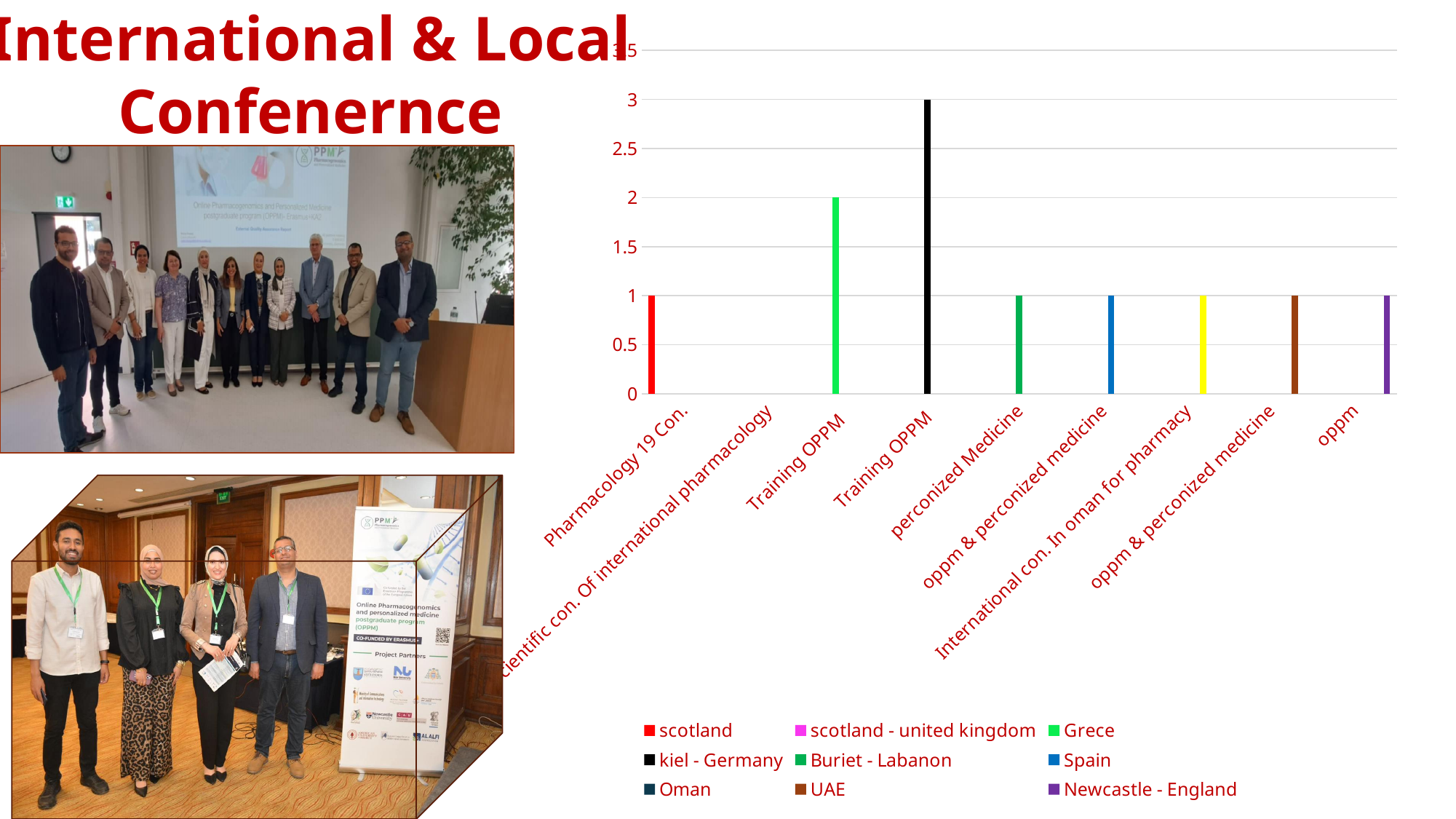
How many series does the chart legend list? 9 What kind of chart is shown on the slide? bar chart What is the value of the bar for the category oppm? 1 Which series has the highest bar in the chart? kiel - Germany What is the value of the bar for the Grece series? 2 What is the difference between the kiel - Germany bar and the Grece bar? 1 Which is larger, the bar for Grece or the bar for Spain? Grece How many categories are shown along the x axis of the chart? 9 Is the value of the kiel - Germany bar greater or less than 2.5? greater What is the value of the bar for the kiel - Germany series? 3 What is the value of the bar for the category Pharmacology 19 Con.? 1 What colour is used for the kiel - Germany series in the legend? black